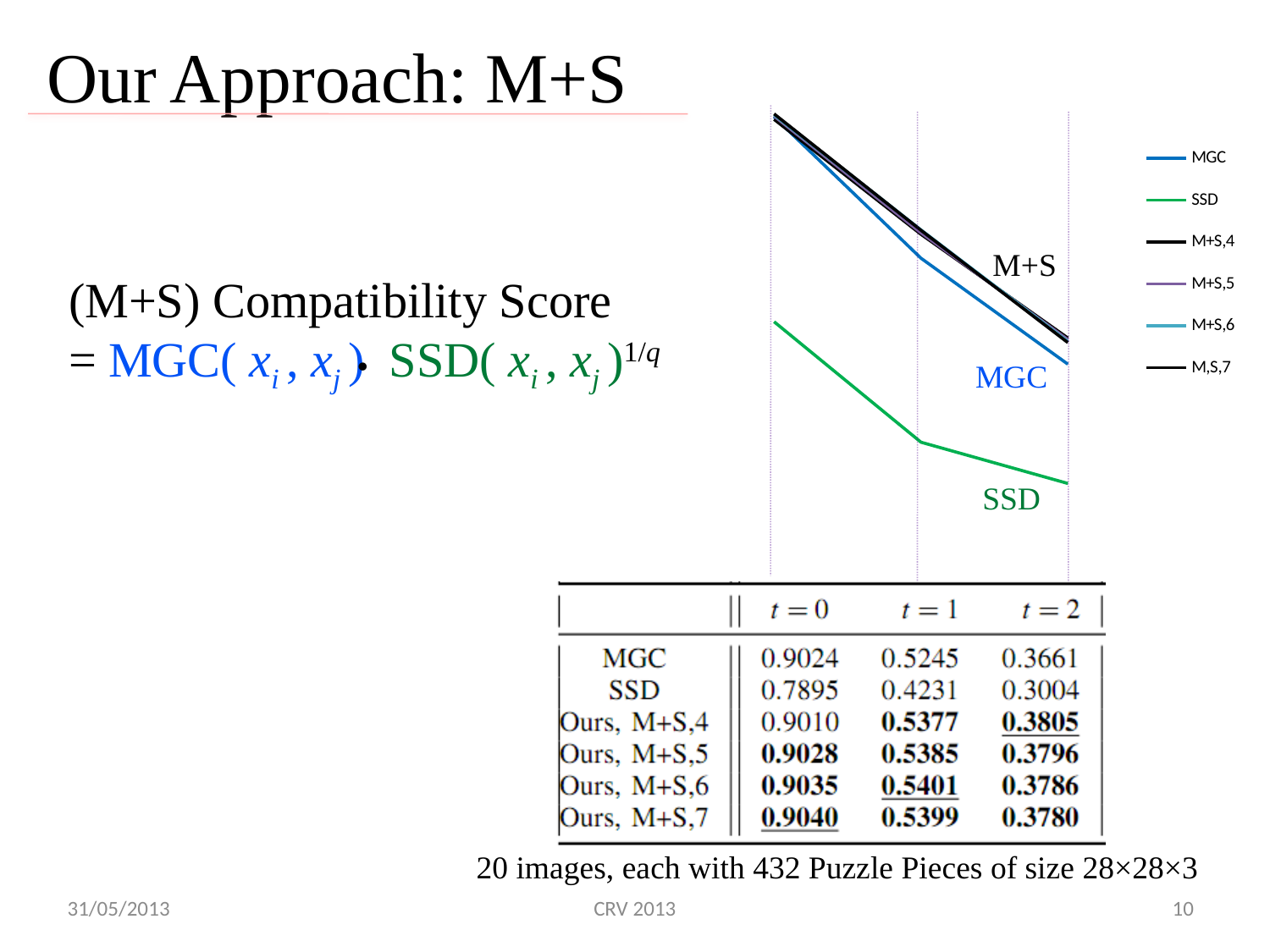
Do the plotted lines rise or fall from left to right? fall How many series does the chart's legend list? 6 At the leftmost point, which is higher: the MGC line or the SSD line? MGC According to the table below the chart, what is the SSD value at t = 2? 0.3004 Which line is lowest on the chart? SSD What colour is the SSD line on the chart? green According to the table, which method has the highest value at t = 0? Ours, M+S,7 According to the table, what is the difference between the MGC and SSD values at t = 1? 0.1014 According to the table, which method has the highest value at t = 2? Ours, M+S,4 What kind of chart is shown on the slide? line chart According to the table below the chart, what is the MGC value at t = 0? 0.9024 How many x positions (t values) are plotted on the chart? 3